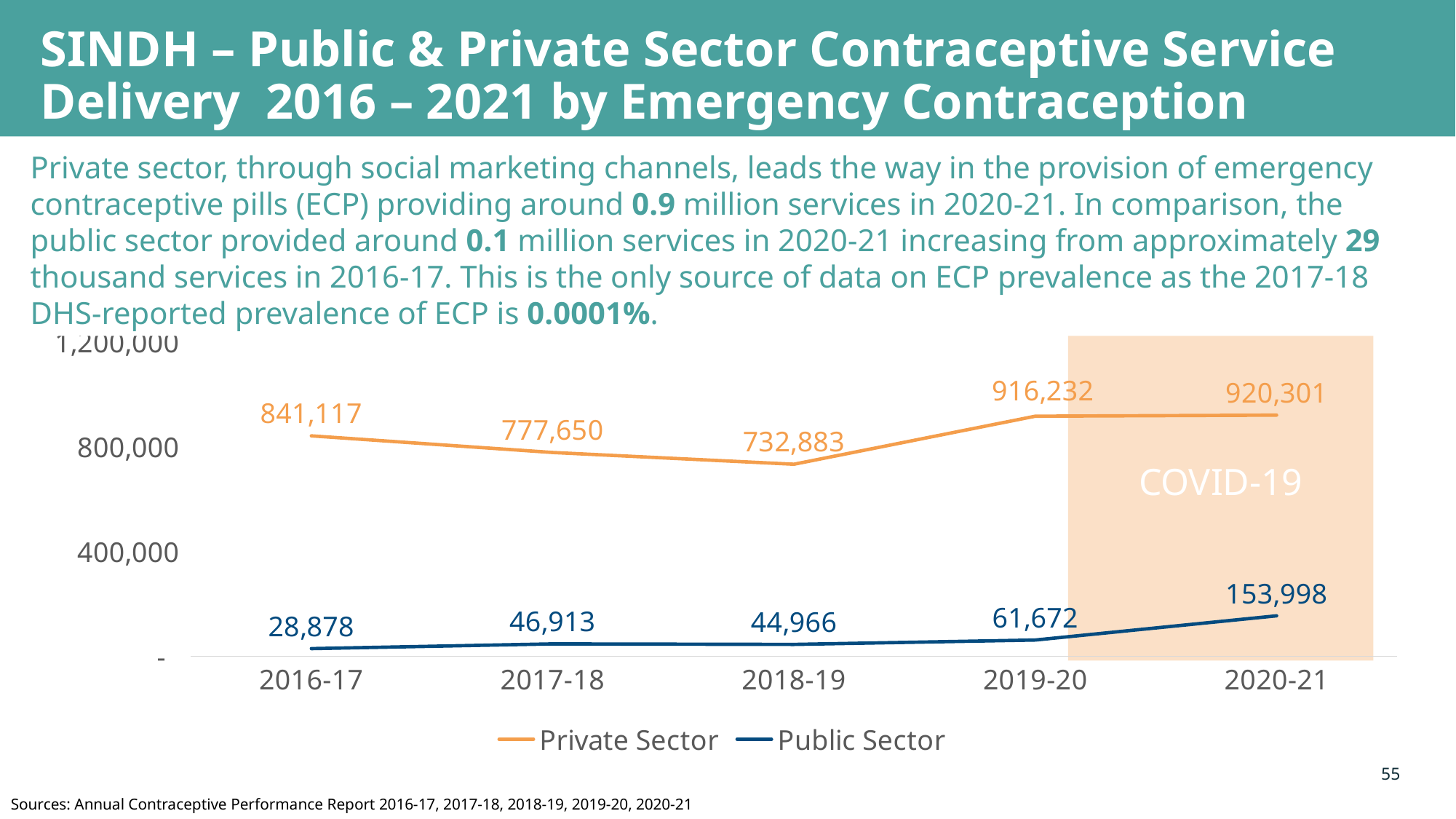
In which year is the Private Sector value lowest? 2018-19 What is the Private Sector value for 2020-21? 920,301 What type of chart is shown on the slide? Line chart What is the Public Sector value for 2017-18? 46,913 Does the Public Sector line rise or fall from 2019-20 to 2020-21? Rise Which is larger, the Private Sector value in 2016-17 or in 2017-18? 2016-17 In which year is the Public Sector value highest? 2020-21 How many years are plotted along the x axis? 5 What is the difference between the Private Sector and Public Sector values in 2020-21? 766,303 How many series does the legend list? 2 By how much did the Public Sector value increase from 2016-17 to 2020-21? 125,120 What is the Private Sector value for 2018-19? 732,883